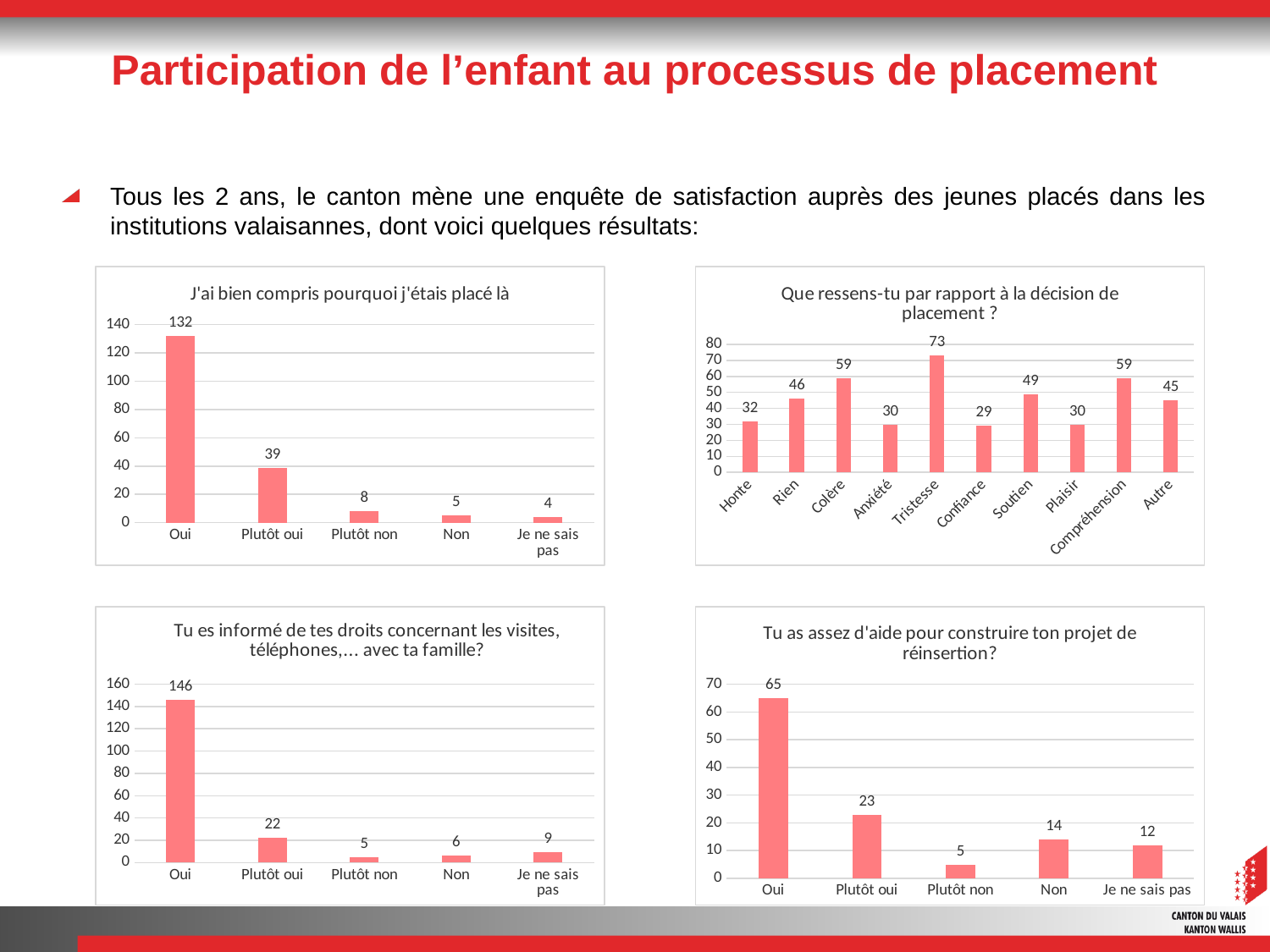
In the chart titled "Que ressens-tu par rapport à la décision de placement ?", what is the value for "Confiance"? 29 In the chart titled "Que ressens-tu par rapport à la décision de placement ?", which is larger, the value for "Soutien" or the value for "Honte"? Soutien How many charts are shown on the slide? 4 In the chart titled "Tu es informé de tes droits concernant les visites, téléphones,... avec ta famille?", what is the value for "Oui"? 146 What kind of chart is the one titled "Tu as assez d'aide pour construire ton projet de réinsertion?"? Bar chart In the chart titled "Tu es informé de tes droits concernant les visites, téléphones,... avec ta famille?", which category has the lowest value? Plutôt non In the chart titled "Tu as assez d'aide pour construire ton projet de réinsertion?", what is the difference between the values for "Oui" and "Plutôt oui"? 42 In the chart titled "Que ressens-tu par rapport à la décision de placement ?", which category has the highest value? Tristesse In the chart titled "J'ai bien compris pourquoi j'étais placé là", what is the difference between the values for "Oui" and "Plutôt oui"? 93 In the chart titled "J'ai bien compris pourquoi j'étais placé là", what is the value for "Plutôt oui"? 39 In the chart titled "Tu as assez d'aide pour construire ton projet de réinsertion?", what is the value for "Non"? 14 In the chart titled "Que ressens-tu par rapport à la décision de placement ?", how many categories are shown on the x axis? 10